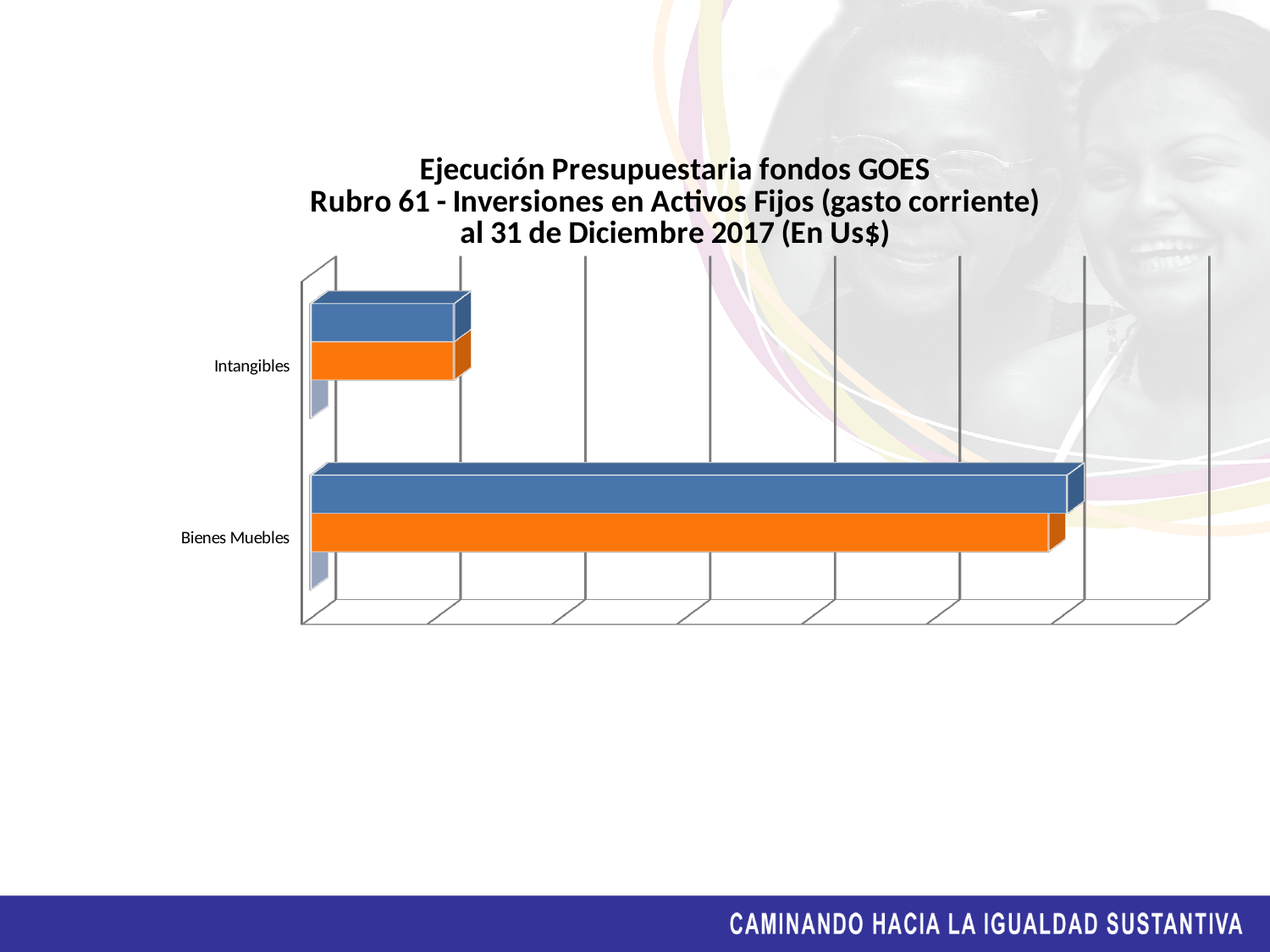
What date does the chart title say the budget execution is reported as of? 31 de Diciembre 2017 What kind of chart is shown on the slide? bar chart Which category has a larger value for the orange series, Intangibles or Bienes Muebles? Bienes Muebles For Bienes Muebles, which bar is longer, the blue one or the orange one? the blue one According to the chart title, in what currency are the values expressed? Us$ Which category has the shortest bars in the chart? Intangibles Which category has the longest bars in the chart? Bienes Muebles Which category has a larger value for the blue series, Intangibles or Bienes Muebles? Bienes Muebles How many categories are shown on the vertical axis of the chart? 2